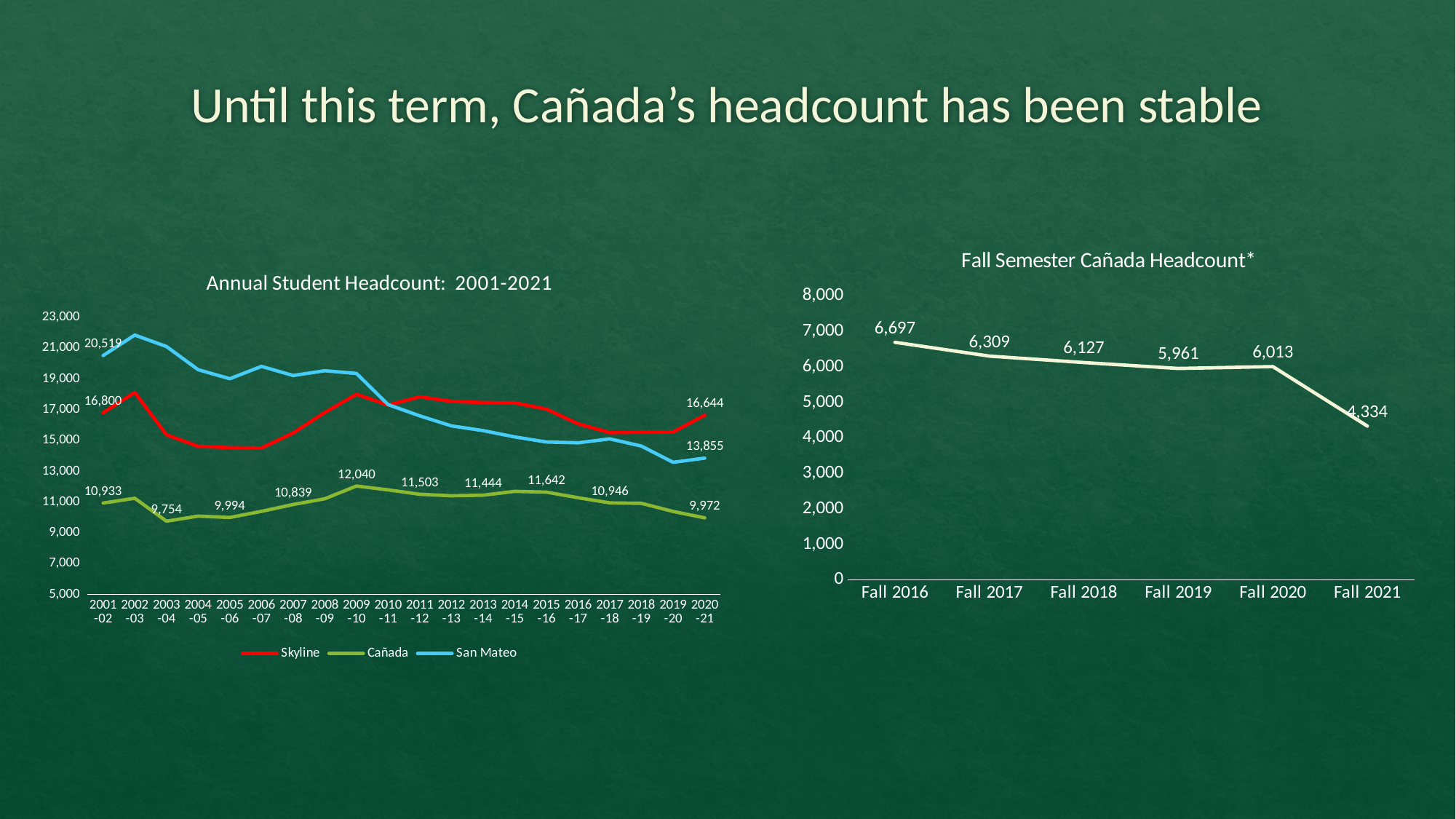
How many series does the legend of the Annual Student Headcount: 2001-2021 chart list? 3 In the Fall Semester Cañada Headcount chart, which term has the lowest headcount? Fall 2021 In the Annual Student Headcount: 2001-2021 chart, what is the Cañada headcount for 2009-10? 12,040 What kind of chart is the Annual Student Headcount: 2001-2021 chart? Line chart In the Fall Semester Cañada Headcount chart, what is the headcount for Fall 2021? 4,334 In the Annual Student Headcount: 2001-2021 chart, which is larger in 2020-21, Skyline or San Mateo? Skyline In the Fall Semester Cañada Headcount chart, which is larger, the Fall 2019 or the Fall 2020 headcount? Fall 2020 In the Fall Semester Cañada Headcount chart, how many terms are plotted? 6 In the Annual Student Headcount: 2001-2021 chart, what is the San Mateo headcount for 2001-02? 20,519 In the Annual Student Headcount: 2001-2021 chart, does the San Mateo line rise or fall overall from 2001-02 to 2020-21? Fall In the Fall Semester Cañada Headcount chart, which term has the highest headcount? Fall 2016 In the Fall Semester Cañada Headcount chart, what is the difference between the Fall 2020 and Fall 2021 headcounts? 1,679